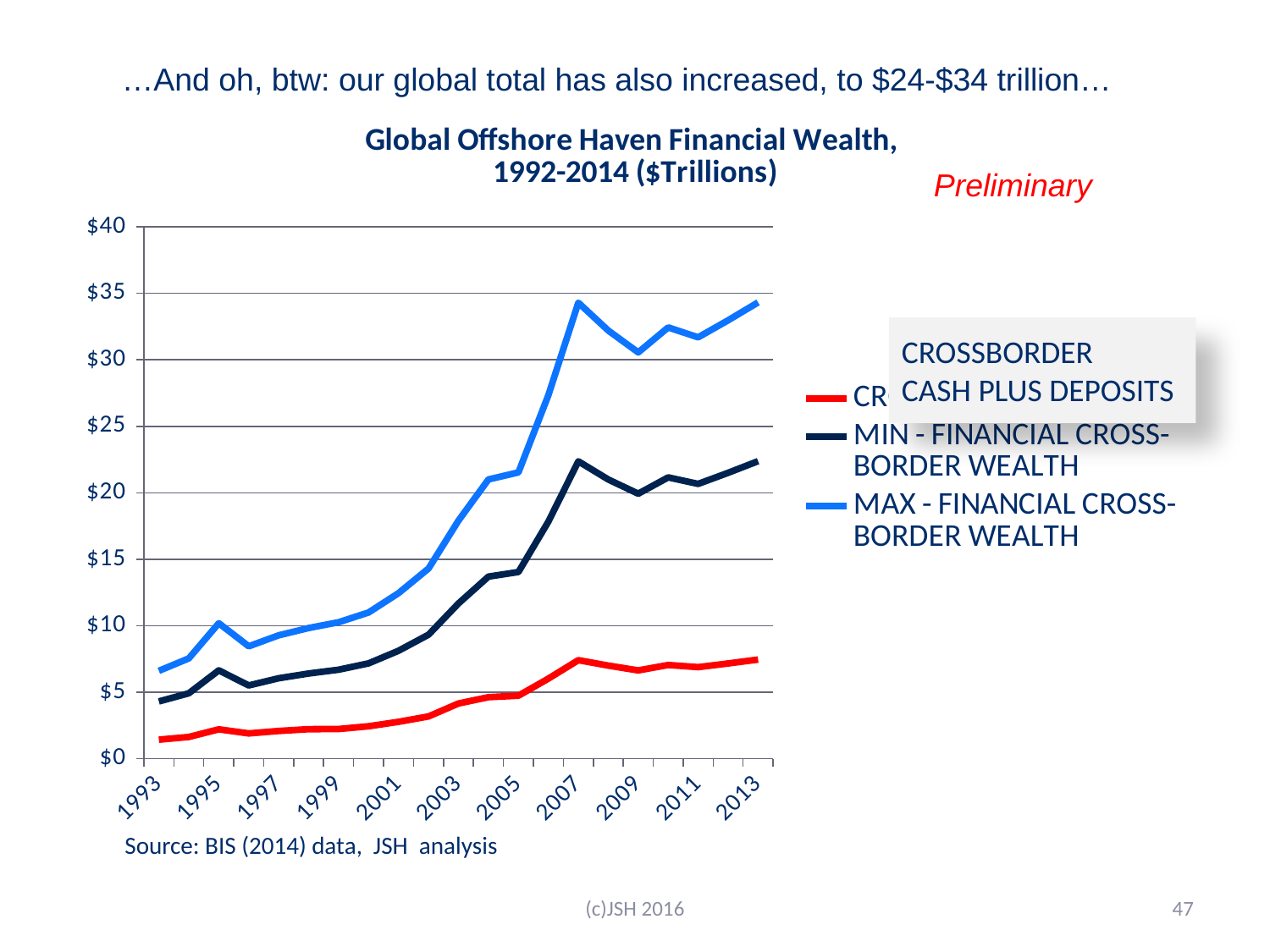
What is the title of the chart? Global Offshore Haven Financial Wealth, 1992-2014 ($Trillions) In which year is the MAX - FINANCIAL CROSS-BORDER WEALTH series at its lowest? 1993 Is the value of MAX - FINANCIAL CROSS-BORDER WEALTH in 2007 greater or less than $30? greater Is the value of MIN - FINANCIAL CROSS-BORDER WEALTH in 2013 greater or less than $20? greater Is the value of MAX - FINANCIAL CROSS-BORDER WEALTH in 1993 greater or less than $10? less In 2013, which is larger: MAX - FINANCIAL CROSS-BORDER WEALTH or MIN - FINANCIAL CROSS-BORDER WEALTH? MAX - FINANCIAL CROSS-BORDER WEALTH In 2001, which is larger: CROSSBORDER CASH PLUS DEPOSITS or MIN - FINANCIAL CROSS-BORDER WEALTH? MIN - FINANCIAL CROSS-BORDER WEALTH Overall, does the MAX - FINANCIAL CROSS-BORDER WEALTH series rise or fall from 1993 to 2013? rise Which colour is used for the MAX - FINANCIAL CROSS-BORDER WEALTH series? light blue What kind of chart is shown on the slide? line chart How many series does the chart's legend list? 3